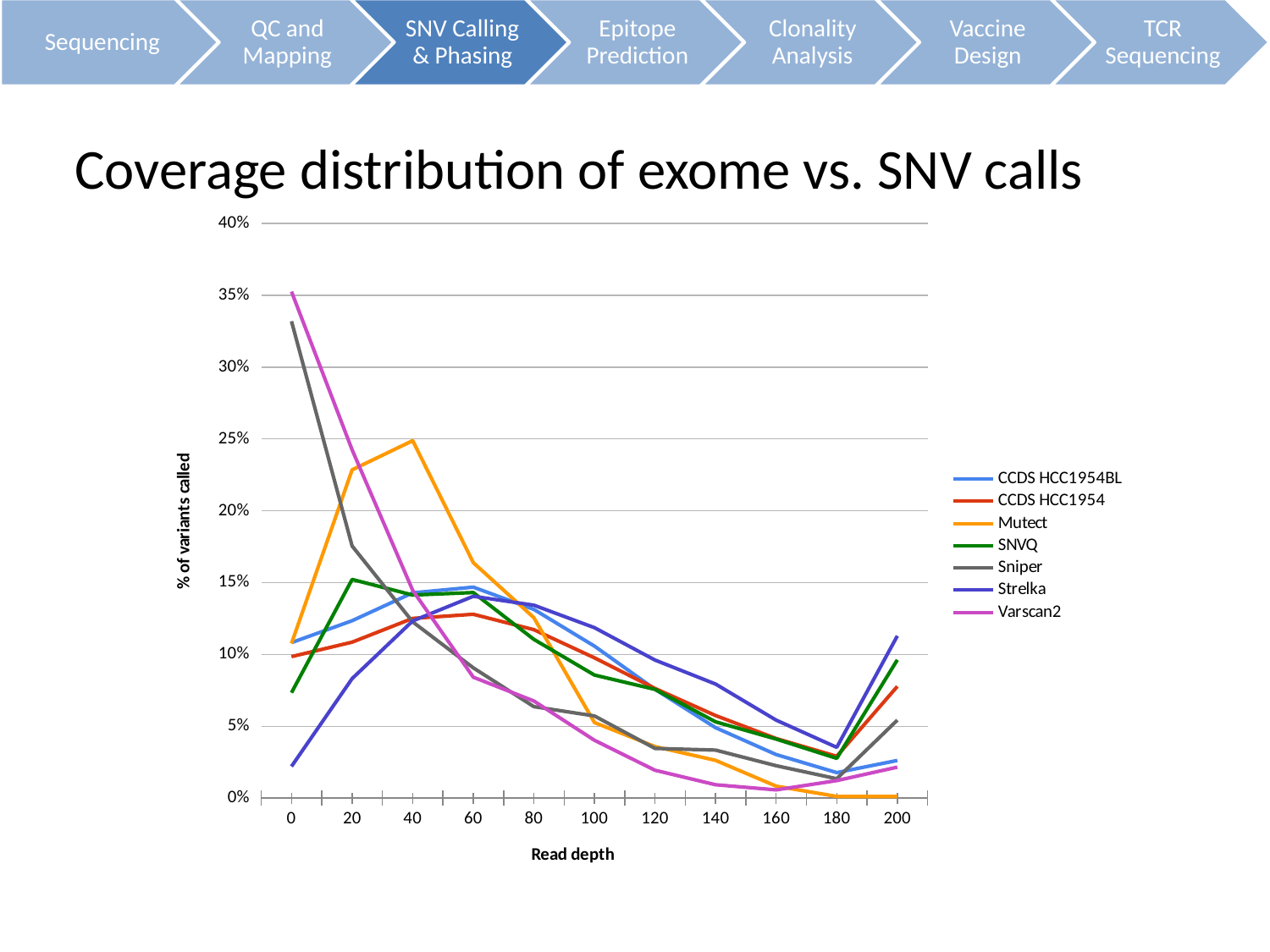
How many series does the legend list? 7 Which series has the highest value at read depth 40? Mutect How many read depth values are marked along the x axis? 11 What kind of chart is shown on the slide? line chart Is the value for Varscan2 at read depth 0 greater or less than 30%? greater Does the Varscan2 line rise or fall between read depth 0 and read depth 160? fall What is the label on the y axis of the chart? % of variants called Is the value for Strelka at read depth 0 greater or less than 5%? less Which series has the lowest value at read depth 0? Strelka Which series has the highest value at read depth 0? Varscan2 Is the value for Mutect at read depth 20 greater or less than 20%? greater At read depth 200, which is larger: Mutect or Strelka? Strelka